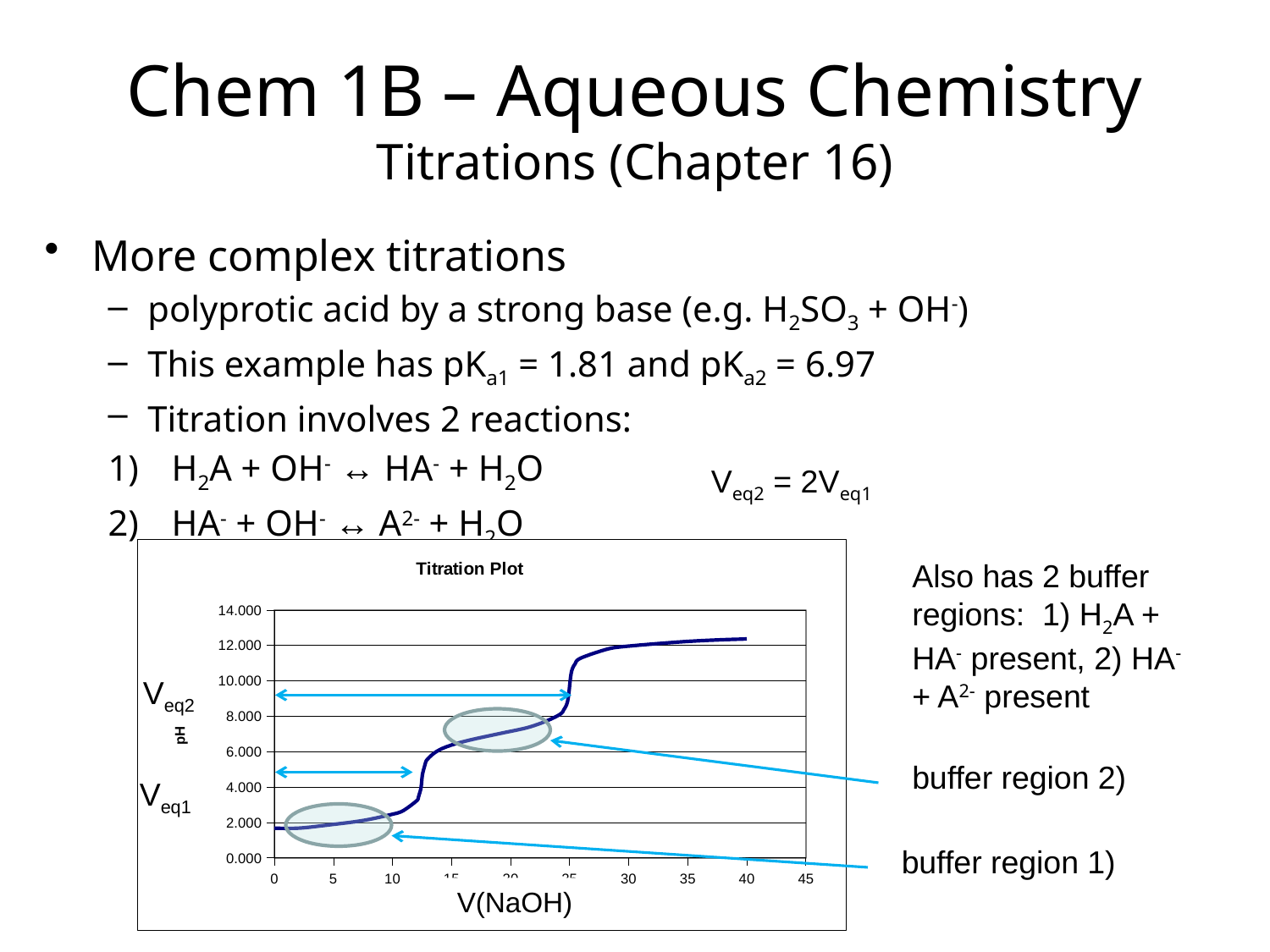
In the Titration Plot, is the pH at V(NaOH) = 30 greater or less than 10.000? greater In the Titration Plot, is the pH at V(NaOH) = 40 greater or less than 12.000? greater In the Titration Plot, is the pH at V(NaOH) = 20 greater or less than 6.000? greater What is the label on the x axis of the Titration Plot? V(NaOH) What is the title of the chart on the slide? Titration Plot What kind of chart is the Titration Plot? line chart In the Titration Plot, does pH rise or fall as V(NaOH) increases? rise In the Titration Plot, is the pH higher at V(NaOH) = 30 or at V(NaOH) = 10? V(NaOH) = 30